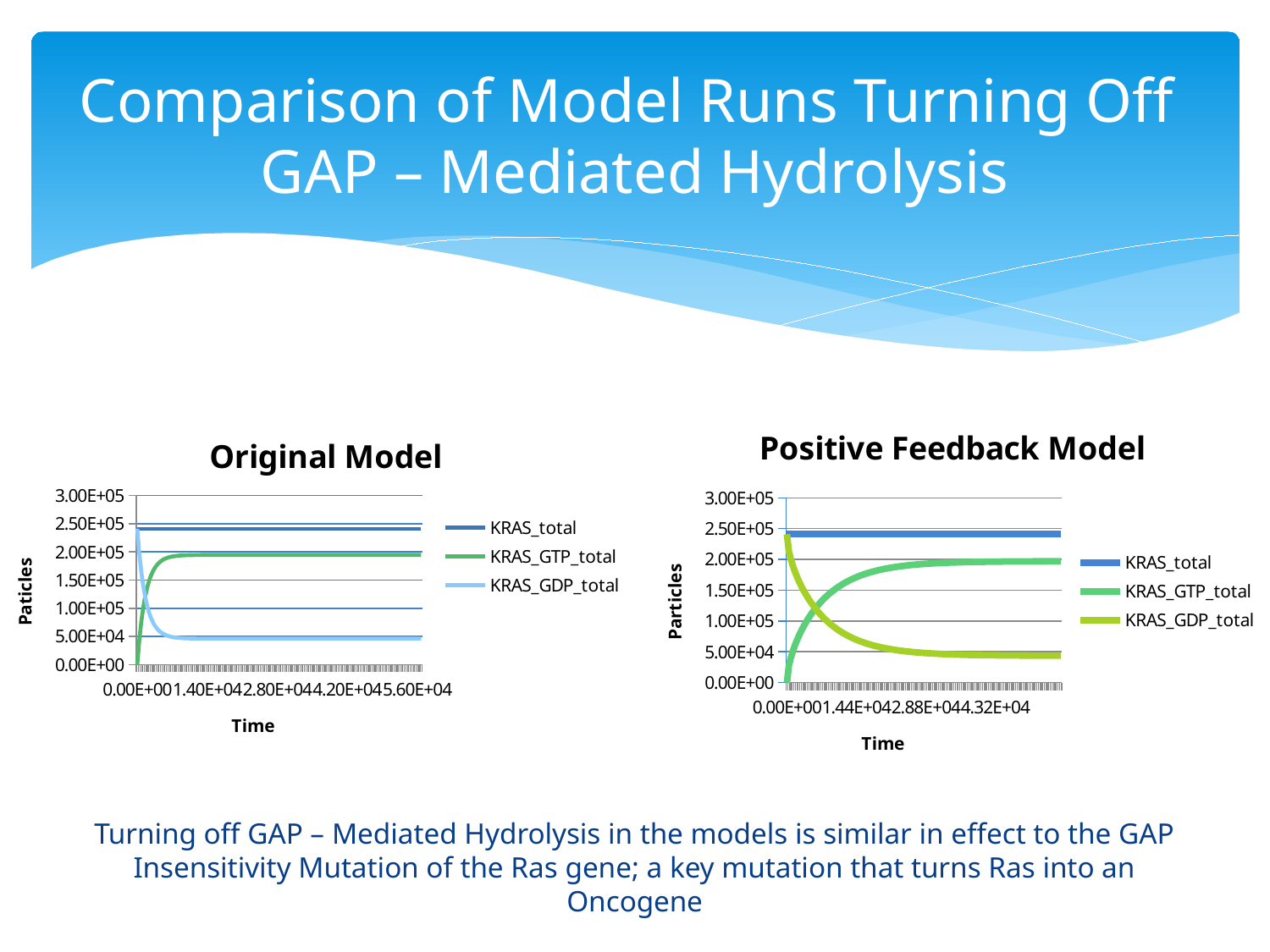
What is the title of the chart on the right? Positive Feedback Model In the Positive Feedback Model chart, does the KRAS_GDP_total series rise or fall along the x axis? fall In the Positive Feedback Model chart, which series has the highest values at the end of the time range? KRAS_total In the Original Model chart, what kind of chart is it? line chart In the Original Model chart, does the KRAS_GTP_total series rise or fall along the x axis? rise In the Original Model chart, at the end of the time range, which is larger: KRAS_GTP_total or KRAS_GDP_total? KRAS_GTP_total In the Positive Feedback Model chart, is the final value of KRAS_GDP_total greater or less than 1.00E+05? less In the Original Model chart, is the value of KRAS_total greater or less than 2.00E+05? greater In the Original Model chart, which series has the lowest values at the end of the time range? KRAS_GDP_total In the Positive Feedback Model chart, is the final value of KRAS_GTP_total greater or less than 1.50E+05? greater In the Positive Feedback Model chart, how many series does the legend list? 3 In the Positive Feedback Model chart, what is the label of the x axis? Time